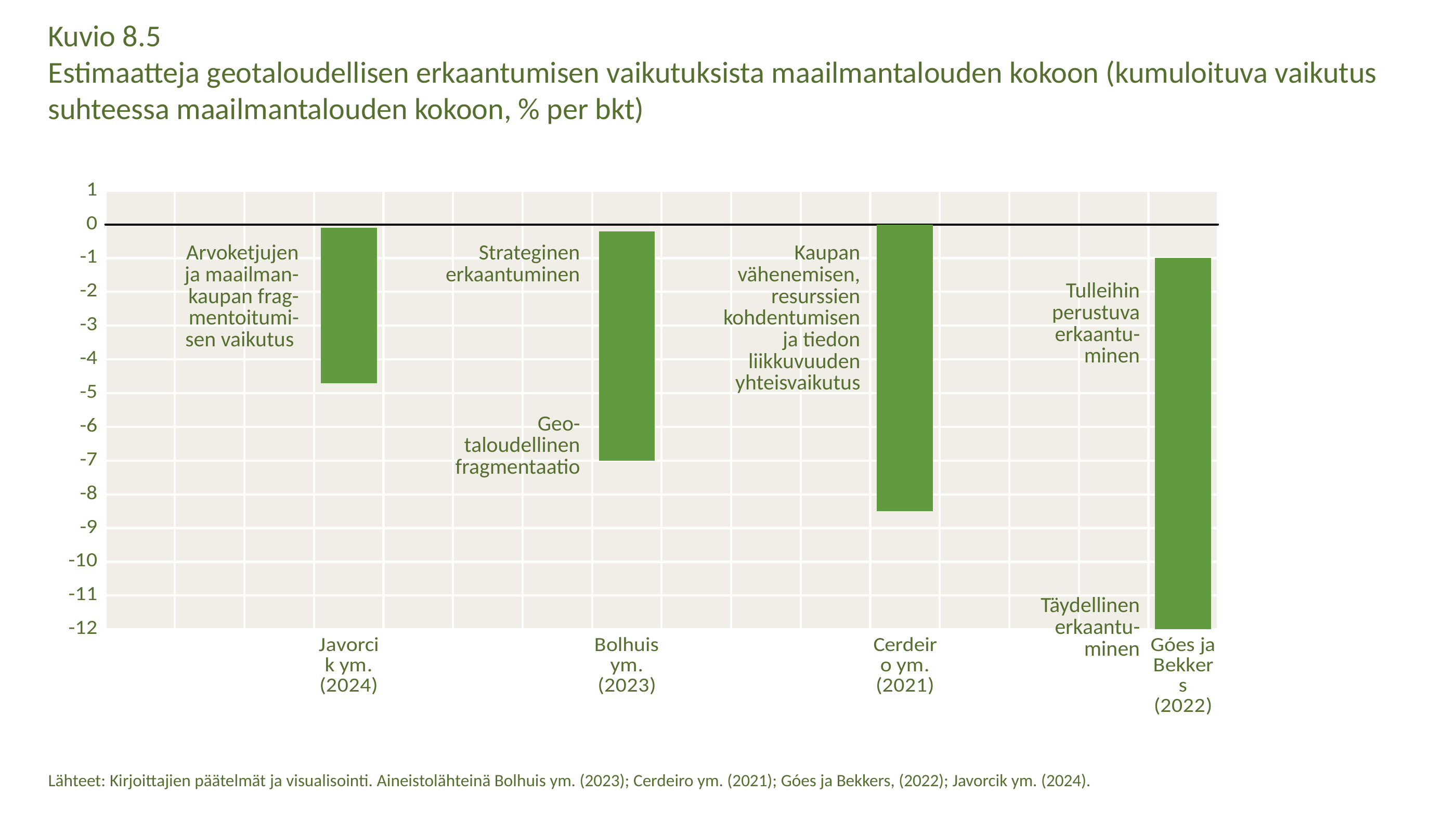
Is the lowest value of the bar for Javorcik ym. (2024) greater or less than -4? less What annotation label is written next to the bar for Góes ja Bekkers (2022) at the bottom of the chart? Täydellinen erkaantuminen Which study's bar extends the least far below zero? Javorcik ym. (2024) Are the plotted values positive or negative? negative What is the lowest value reached by the bar for Bolhuis ym. (2023)? -7 Which bar reaches further below zero, Bolhuis ym. (2023) or Cerdeiro ym. (2021)? Cerdeiro ym. (2021) Is the lowest value of the bar for Cerdeiro ym. (2021) greater or less than -9? greater Which study's bar extends to the lowest value on the chart? Góes ja Bekkers (2022) What is the lowest value reached by the bar for Góes ja Bekkers (2022)? -12 How many studies (bars) are plotted on the chart? 4 What kind of chart is shown on the slide? bar chart What is the figure number given in the chart title? Kuvio 8.5